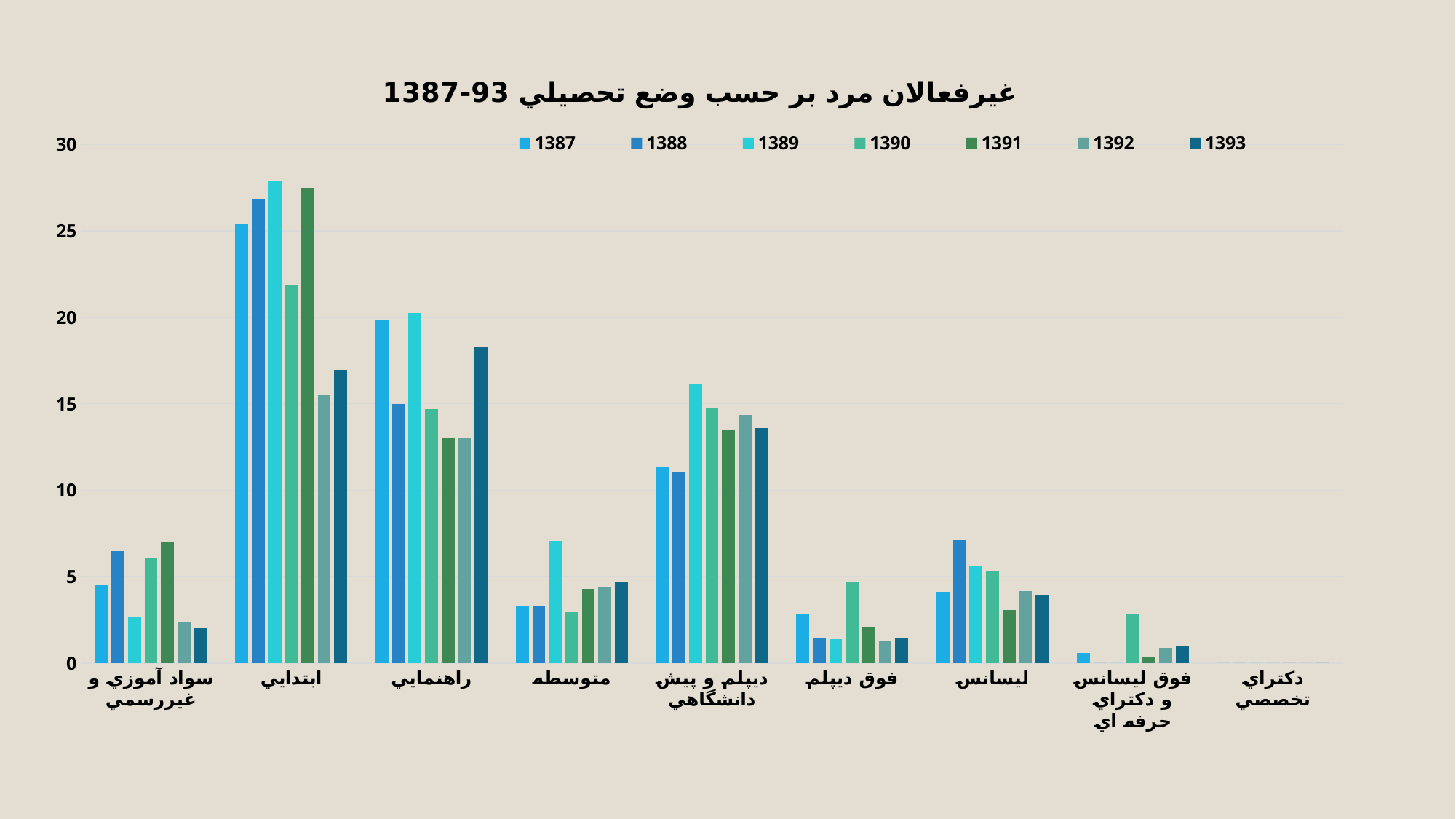
Which education category has the tallest bars overall? ابتدايي Is the 1390 value for ابتدايي greater or less than 25? less What kind of chart is shown on the slide? bar chart How many series does the legend list? 7 For راهنمايي, which year has the larger value, 1387 or 1388? 1387 How many education categories are shown on the x axis? 9 Is the 1389 value for ابتدايي greater or less than 25? greater For ديپلم و پيش دانشگاهي, which year has the larger value, 1387 or 1389? 1389 What is the title of the chart? غيرفعالان مرد بر حسب وضع تحصيلي 1387-93 Is the 1393 value for راهنمايي greater or less than 15? greater Which education category has the lowest values across all years? دكتراي تخصصي